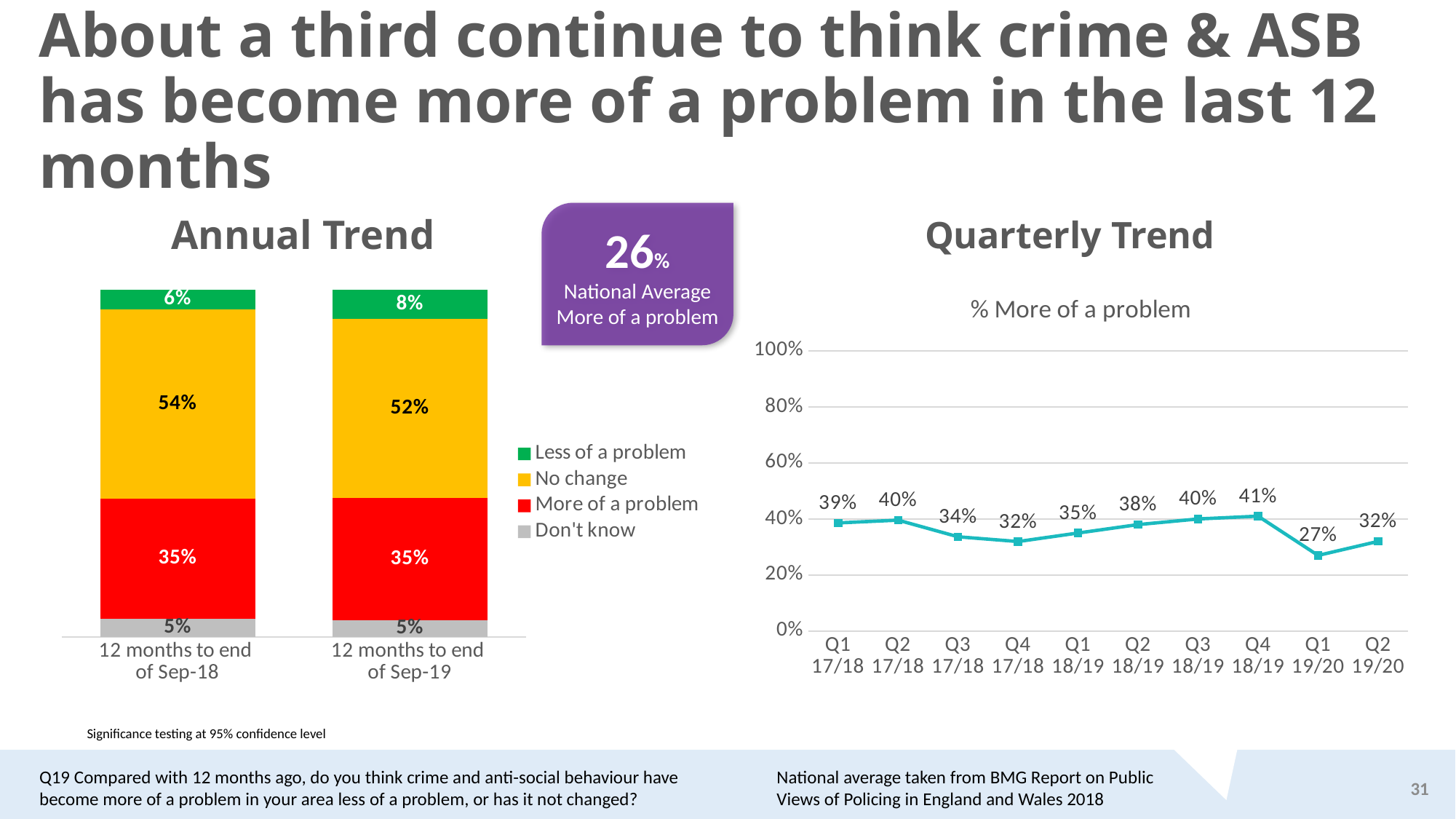
What kind of chart is the Annual Trend chart? Stacked bar chart In the Annual Trend chart, what percentage said 'Less of a problem' in the 12 months to end of Sep-18? 6% In the Quarterly Trend chart, what is the value for Q1 19/20? 27% In the Quarterly Trend chart, which quarter has the highest value? Q4 18/19 What kind of chart is the Quarterly Trend chart? Line chart In the Annual Trend chart, what is the difference between the 'No change' values for Sep-18 and Sep-19? 2% In the Annual Trend chart, how many series does the legend list? 4 In the Quarterly Trend chart, what is the difference between Q4 18/19 and Q1 19/20? 14% In the Annual Trend chart, what percentage said 'No change' in the 12 months to end of Sep-19? 52% In the Quarterly Trend chart, how many quarters are plotted? 10 In the Annual Trend chart, which colour represents 'More of a problem'? Red In the Quarterly Trend chart, which quarter has the lowest value? Q1 19/20